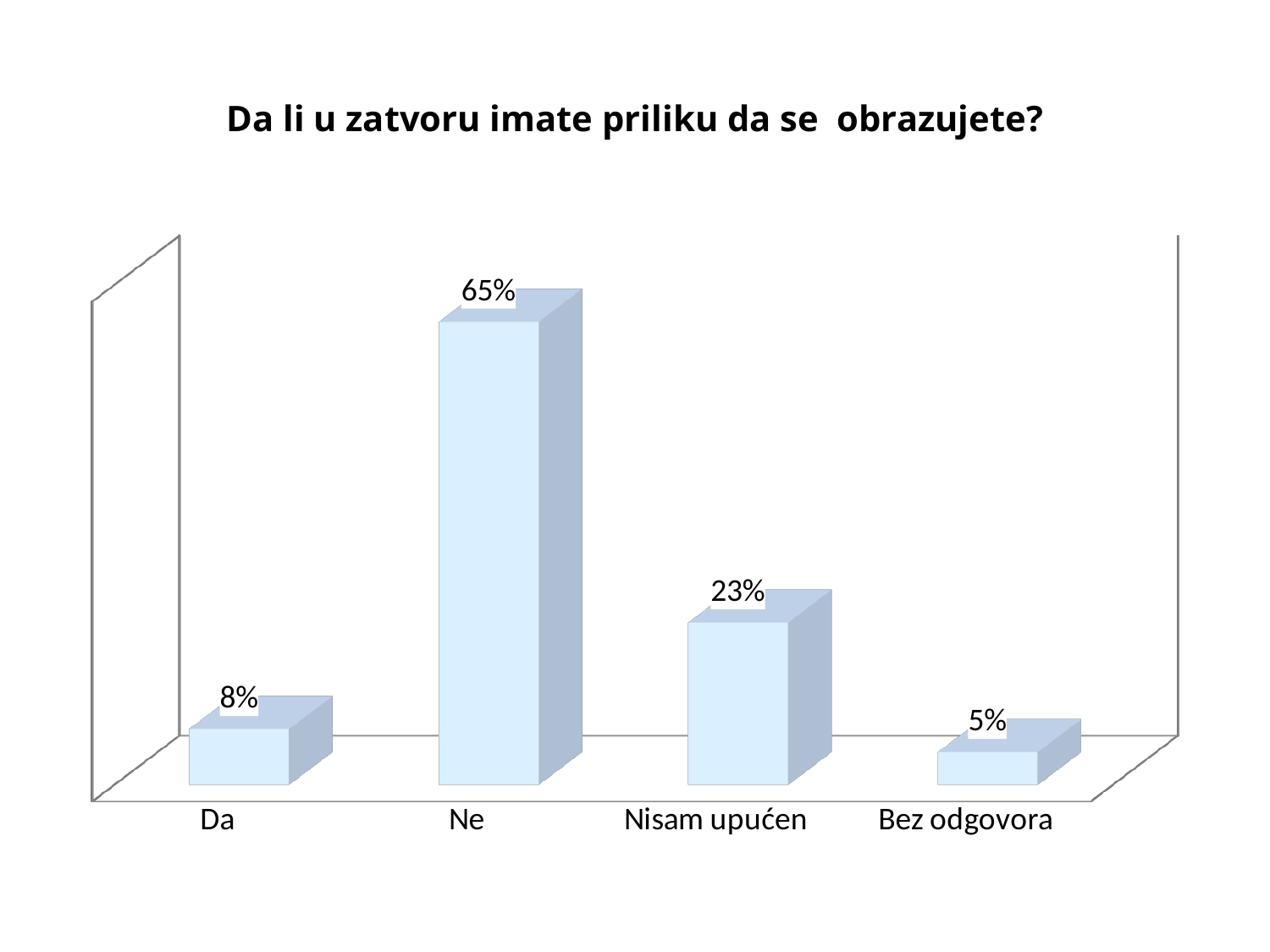
What kind of chart is shown on the slide? Bar chart What is the title of the chart? Da li u zatvoru imate priliku da se obrazujete? What is the value for "Nisam upućen"? 23% Which is larger, the value for "Da" or the value for "Nisam upućen"? Nisam upućen Which category has the lowest value? Bez odgovora Which category has the highest value? Ne What is the value for "Ne"? 65% What is the value for "Bez odgovora"? 5% What is the difference between the values for "Da" and "Bez odgovora"? 3% What is the value for "Da"? 8% What is the difference between the values for "Ne" and "Nisam upućen"? 42% How many categories are shown on the chart? 4